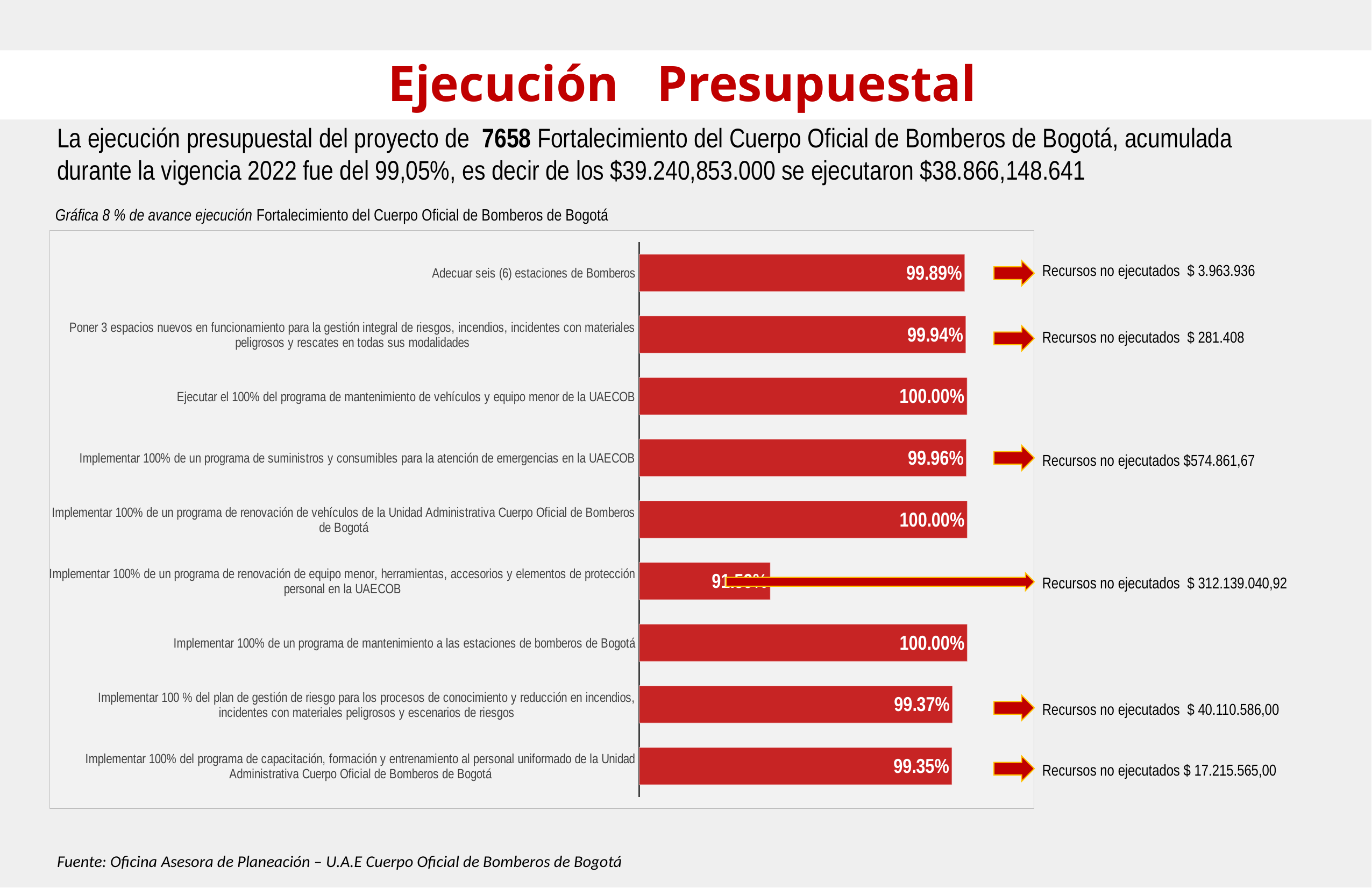
What is the value for "Implementar 100 % del plan de gestión de riesgo para los procesos de conocimiento y reducción en incendios, incidentes con materiales peligrosos y escenarios de riesgos"? 99.37% What is the value for "Implementar 100% del programa de capacitación, formación y entrenamiento al personal uniformado de la Unidad Administrativa Cuerpo Oficial de Bomberos de Bogotá"? 99.35% What colour are the bars in the chart? Red How many bars in the chart show a value of 100.00%? 3 Which is larger: the value for "Poner 3 espacios nuevos en funcionamiento..." or the value for "Implementar 100 % del plan de gestión de riesgo..."? Poner 3 espacios nuevos en funcionamiento... What is the value for "Implementar 100% de un programa de suministros y consumibles para la atención de emergencias en la UAECOB"? 99.96% What type of chart is shown on the slide? Bar chart What is the value for "Adecuar seis (6) estaciones de Bomberos"? 99.89% Which category has the lowest value in the chart? Implementar 100% de un programa de renovación de equipo menor, herramientas, accesorios y elementos de protección personal en la UAECOB What is the value for "Poner 3 espacios nuevos en funcionamiento para la gestión integral de riesgos, incendios, incidentes con materiales peligrosos y rescates en todas sus modalidades"? 99.94% What is the difference between the value for "Adecuar seis (6) estaciones de Bomberos" (99.89%) and the value for "Implementar 100% del programa de capacitación..." (99.35%)? 0.54 percentage points How many categories (bars) does the chart show? 9